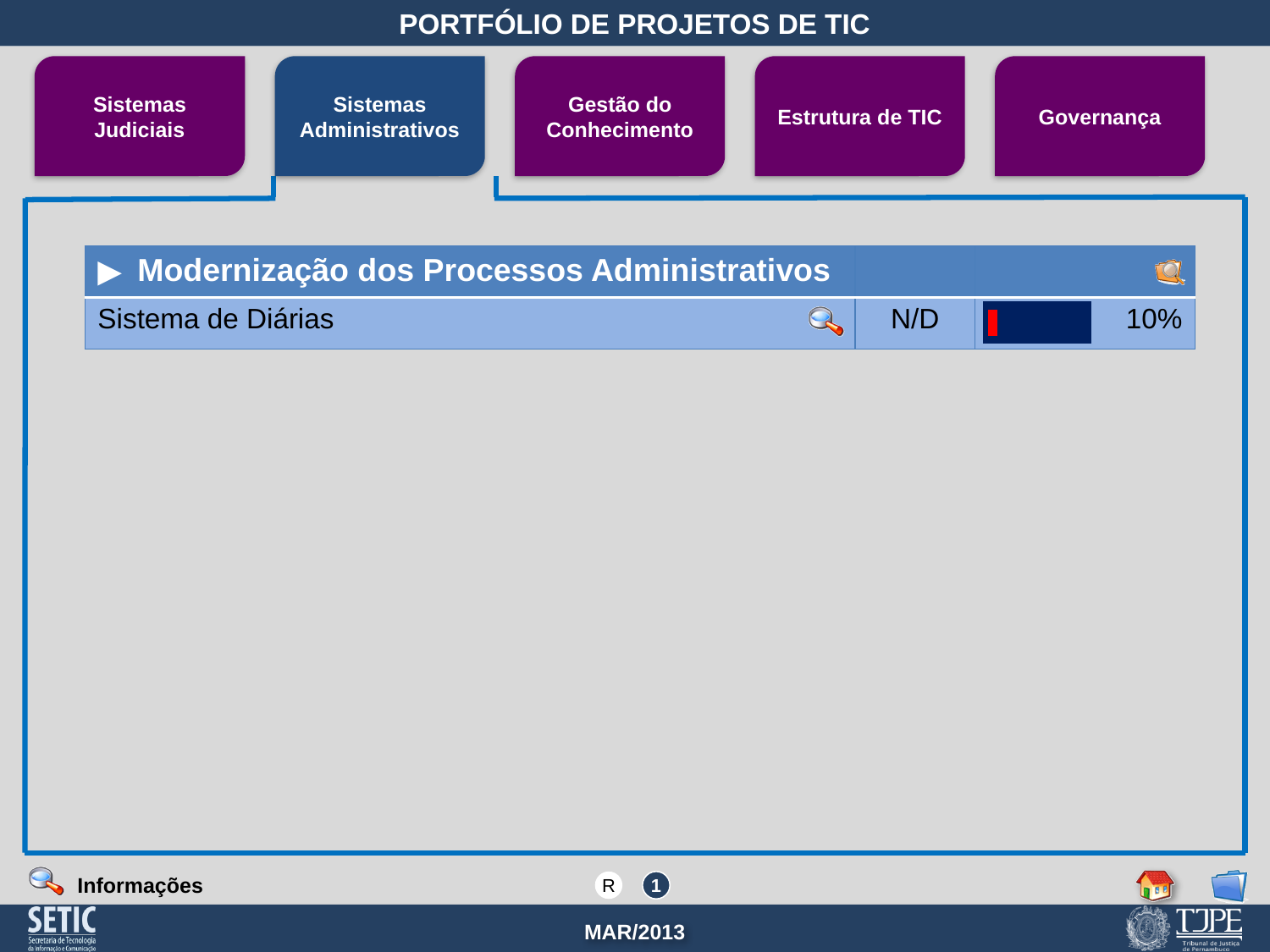
What colour is the filled portion of the progress bar for Sistema de Diárias? red How many projects are listed under Modernização dos Processos Administrativos? 1 What is the name of the project group heading above Sistema de Diárias? Modernização dos Processos Administrativos What kind of chart is used to show the progress of Sistema de Diárias? bar chart Is the progress value for Sistema de Diárias greater or less than 50%? less What value is shown in the column before the progress bar for Sistema de Diárias? N/D What completion percentage is shown for Sistema de Diárias? 10%